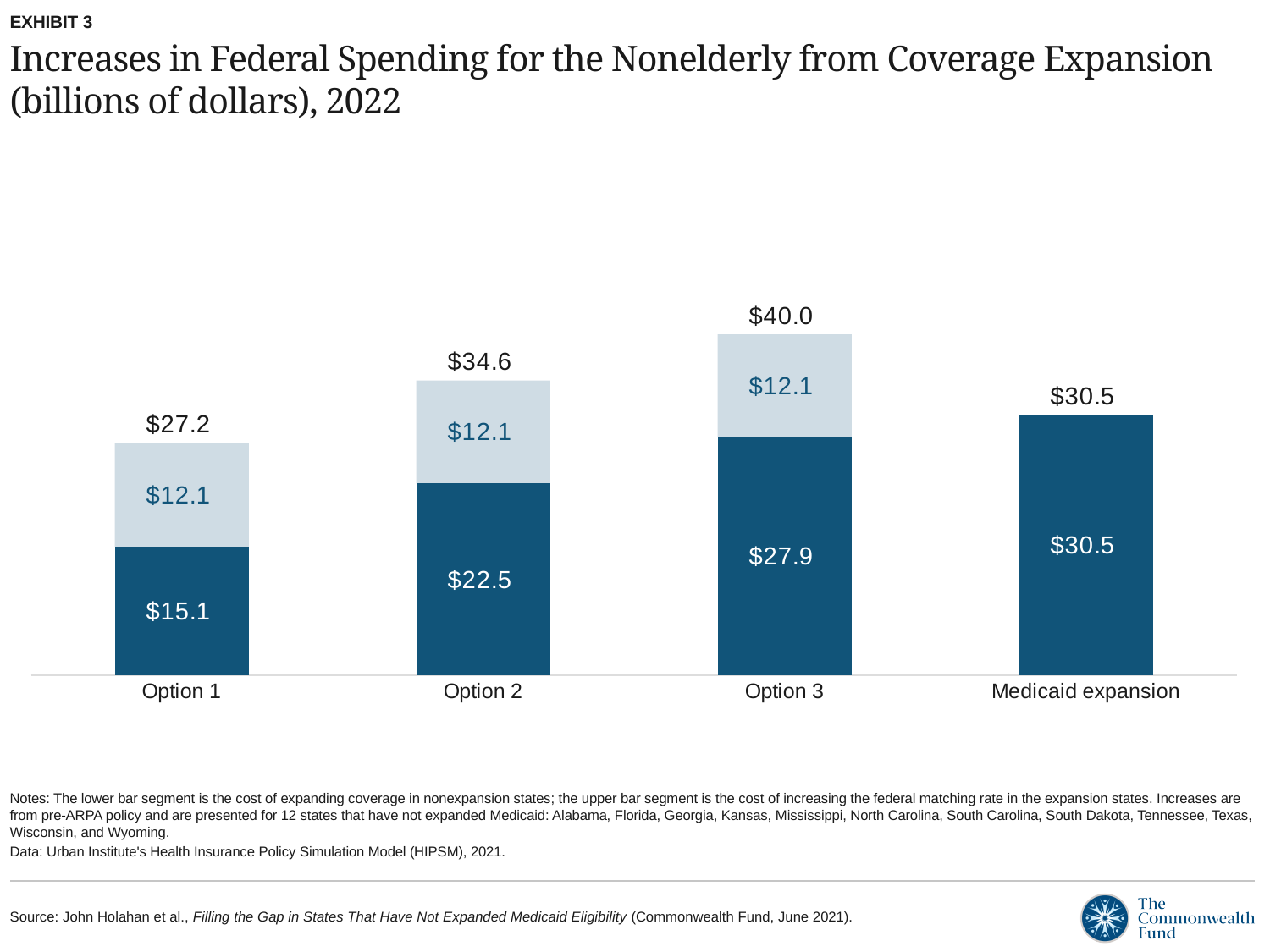
What is the difference between the lower segment of Option 2 and the lower segment of Option 1? $7.4 What is the value of the lower (dark) segment for Option 3? $27.9 What is the total value of the stacked bar for Option 2? $34.6 What is the difference between the total for Option 3 and the total for Option 1? $12.8 Which category has the highest total? Option 3 Do the bar totals rise or fall from Option 1 to Option 3? Rise Which is larger: the total for Option 2 or the value for Medicaid expansion? Option 2 How many categories are shown on the x axis? 4 What is the value shown for Medicaid expansion? $30.5 What kind of chart is shown on the slide? Stacked bar chart Which category has the lowest total? Option 1 What is the value of the upper (light) segment for Option 1? $12.1